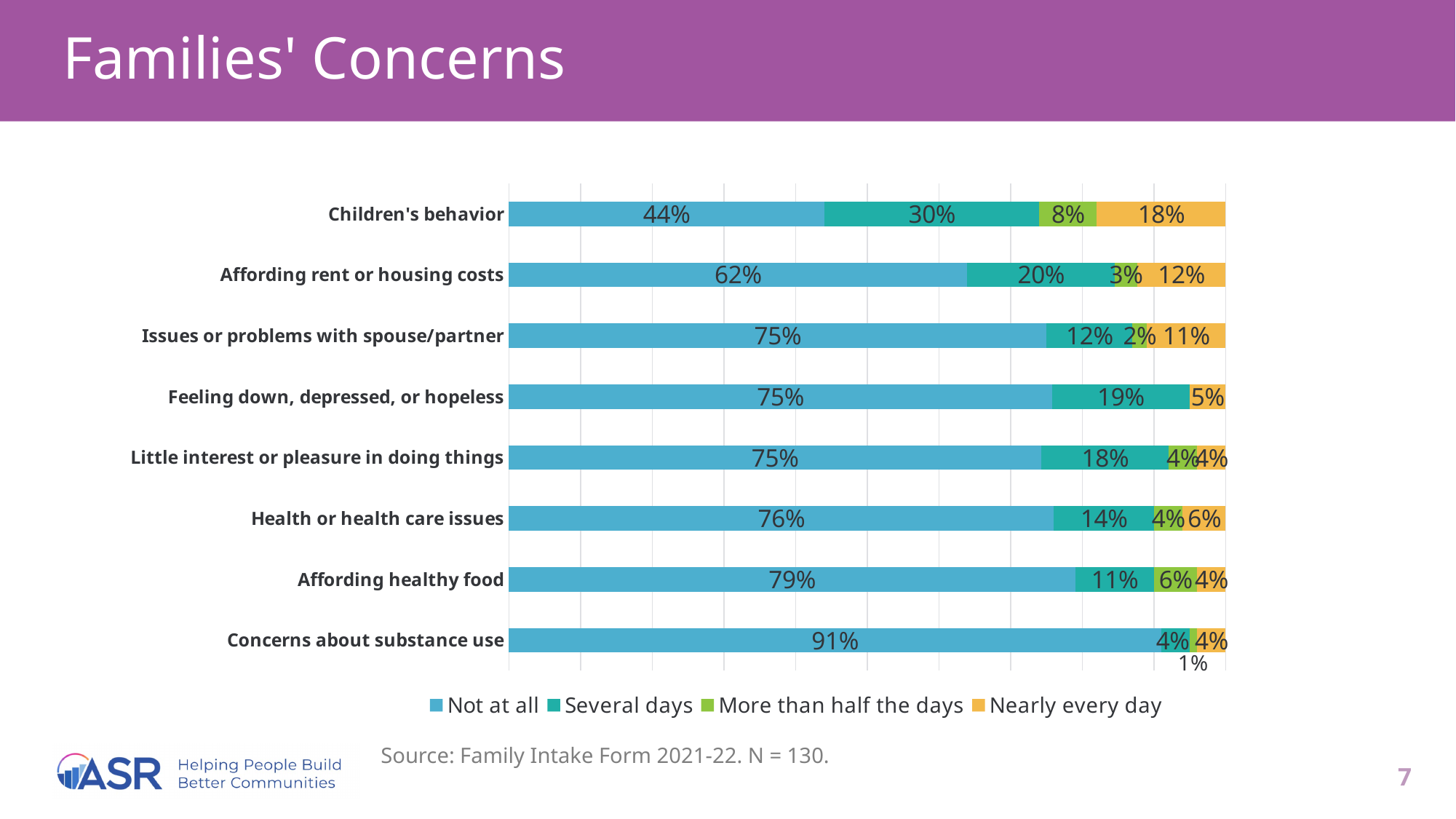
What is the 'More than half the days' value for Affording healthy food? 6% What is the 'Not at all' value for Children's behavior? 44% Which is larger: the 'Several days' value for Children's behavior or for Health or health care issues? Children's behavior How many concern categories are plotted in the chart? 8 What is the 'Nearly every day' value for Affording rent or housing costs? 12% What is the difference between the 'Not at all' values for Concerns about substance use and Children's behavior? 47 percentage points How many series does the legend list? 4 What is the 'Several days' value for Feeling down, depressed, or hopeless? 19% Which category has the lowest 'Not at all' value? Children's behavior Which category has the highest 'Not at all' value? Concerns about substance use Which series is shown in orange in the legend? Nearly every day What kind of chart is shown on the slide? Stacked bar chart